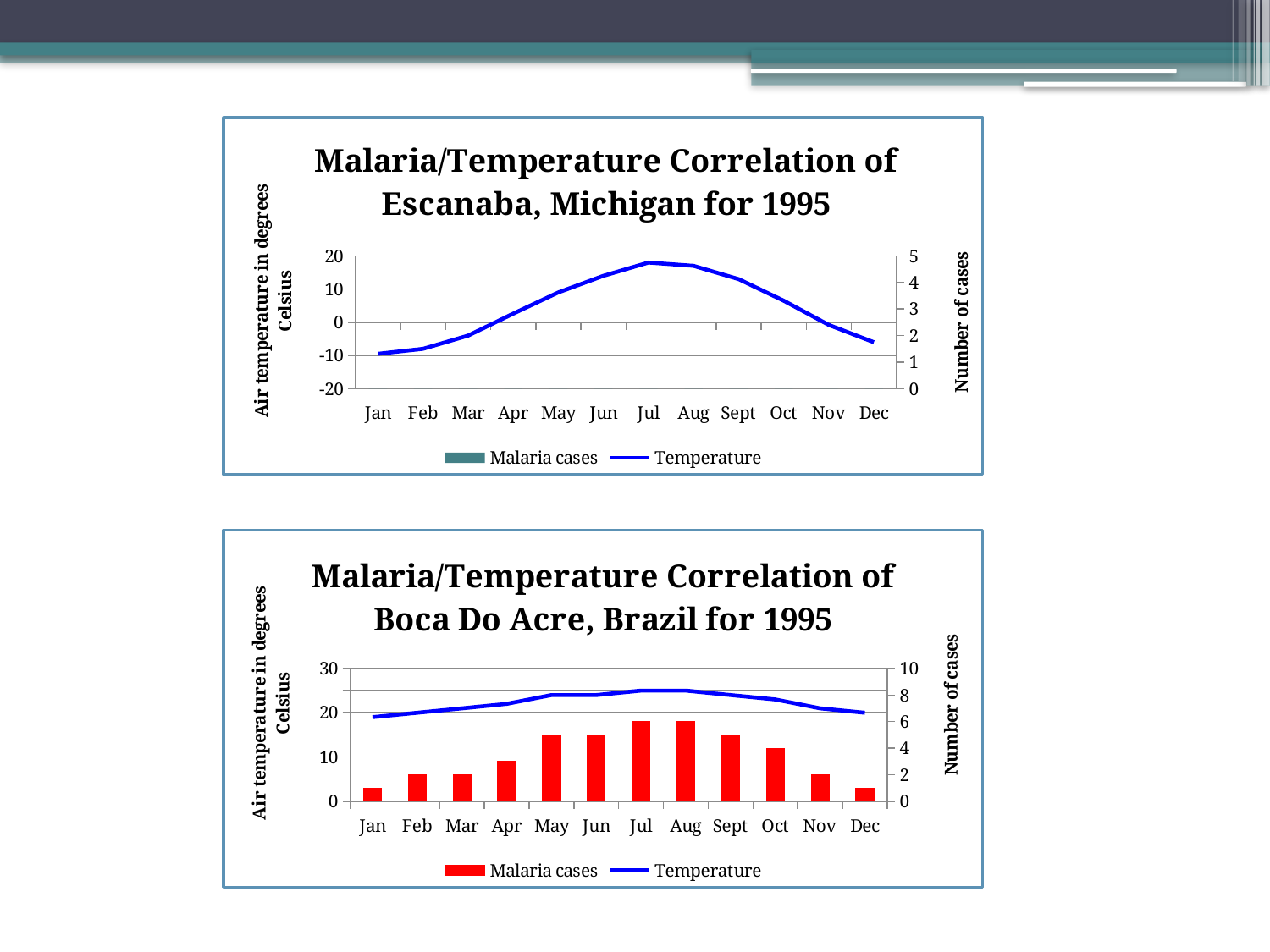
What are the two legend entries in the bottom chart for Boca Do Acre, Brazil? Malaria cases and Temperature In the bottom chart for Boca Do Acre, Brazil, is the temperature in Jul greater or less than 20? greater How many months are shown on the x axis of the bottom chart for Boca Do Acre, Brazil? 12 How many series does the legend of the top chart, 'Malaria/Temperature Correlation of Escanaba, Michigan for 1995', list? 2 In the bottom chart for Boca Do Acre, Brazil, which month has more malaria cases, Jul or Jan? Jul In the top chart for Escanaba, Michigan, is the temperature in Jan greater or less than 0? less What kind of chart is the bottom chart, 'Malaria/Temperature Correlation of Boca Do Acre, Brazil for 1995'? Combined bar and line chart In the bottom chart for Boca Do Acre, Brazil, is the number of malaria cases in Jul greater or less than 4? greater In the top chart for Escanaba, Michigan, does the temperature rise or fall from Jan to Jul? rise In the bottom chart for Boca Do Acre, Brazil, how many malaria cases are shown for Oct? 4